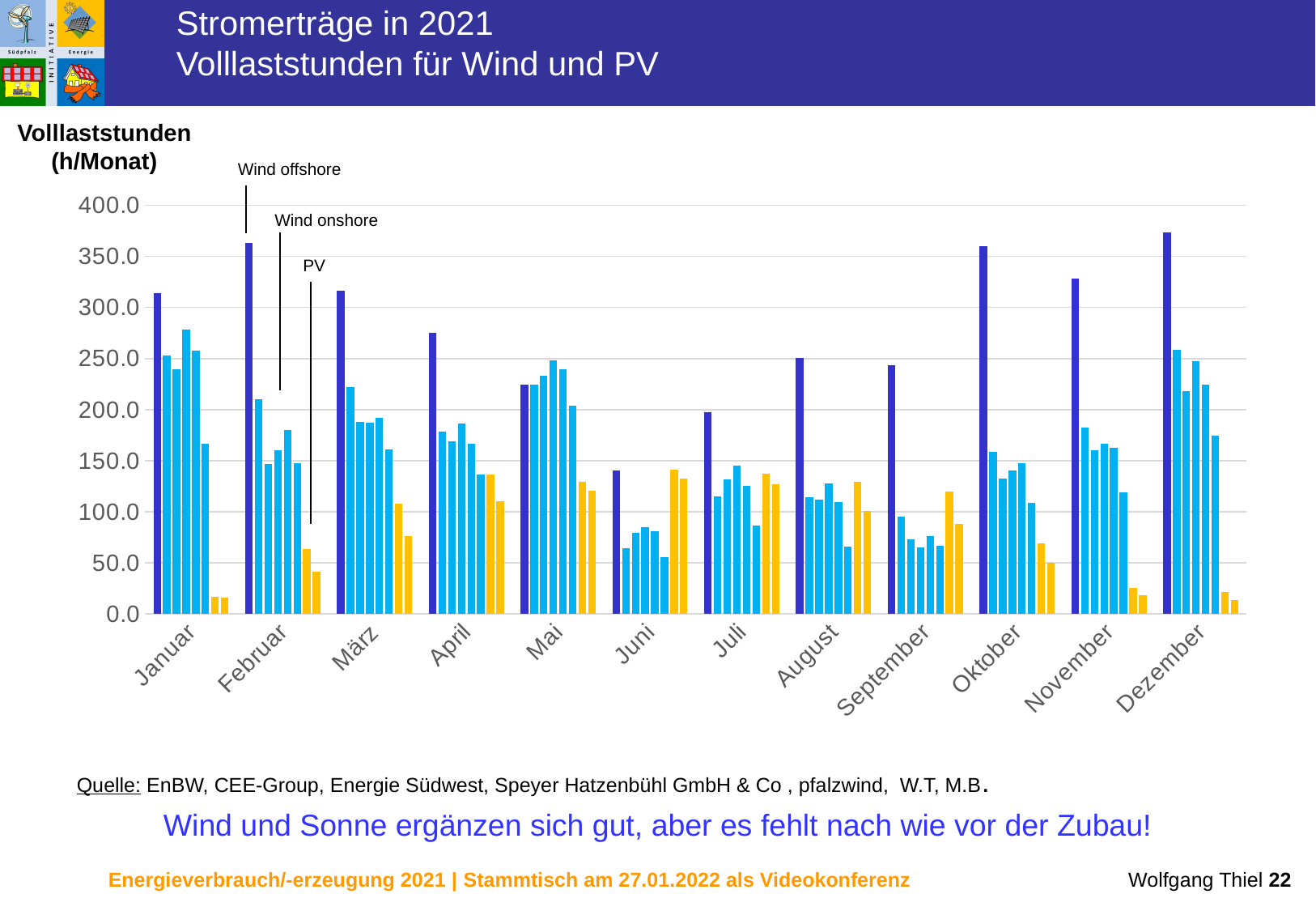
What colour are the PV bars in the chart? yellow Is the Wind offshore value for Oktober greater or less than 350? greater How many series are labelled in the chart (Wind offshore, Wind onshore, PV)? 3 Is the Wind offshore value for Juni greater or less than 150? less Which month has the larger Wind offshore value, Januar or Juni? Januar In which month is the Wind offshore value lowest? Juni Is the Wind offshore value for Januar greater or less than 300? greater What kind of chart is shown on the slide? bar chart How many months are shown along the x axis of the chart? 12 What is the label of the y axis of the chart? Volllaststunden (h/Monat)